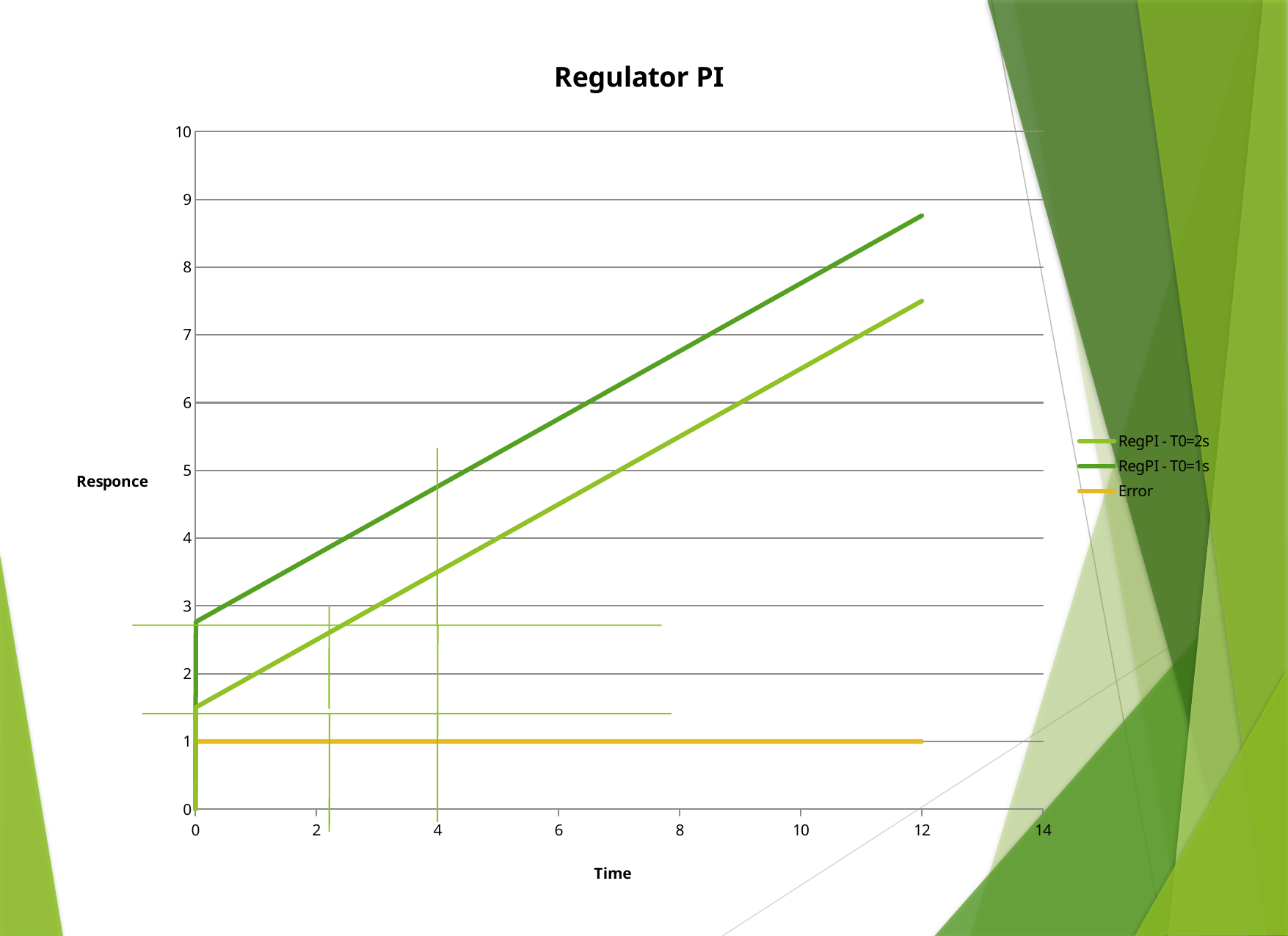
What kind of chart is shown on the slide? line chart What is the value of the Error series across the plotted time range? 1 Is the value of RegPI - T0=1s at Time 12 greater or less than 8? greater Does the Error series rise, fall, or stay flat as Time increases? stay flat What are the labels of the x axis and y axis? Time and Responce At Time 12, which series has the higher value, RegPI - T0=1s or RegPI - T0=2s? RegPI - T0=1s What is the title of the chart? Regulator PI Is the value of RegPI - T0=2s at Time 12 greater or less than 8? less Which series has the lowest value at Time 12? Error How many series does the legend list? 3 Is the value of RegPI - T0=1s at Time 0 greater or less than 3? less Does the RegPI - T0=1s series rise or fall as Time increases? rise